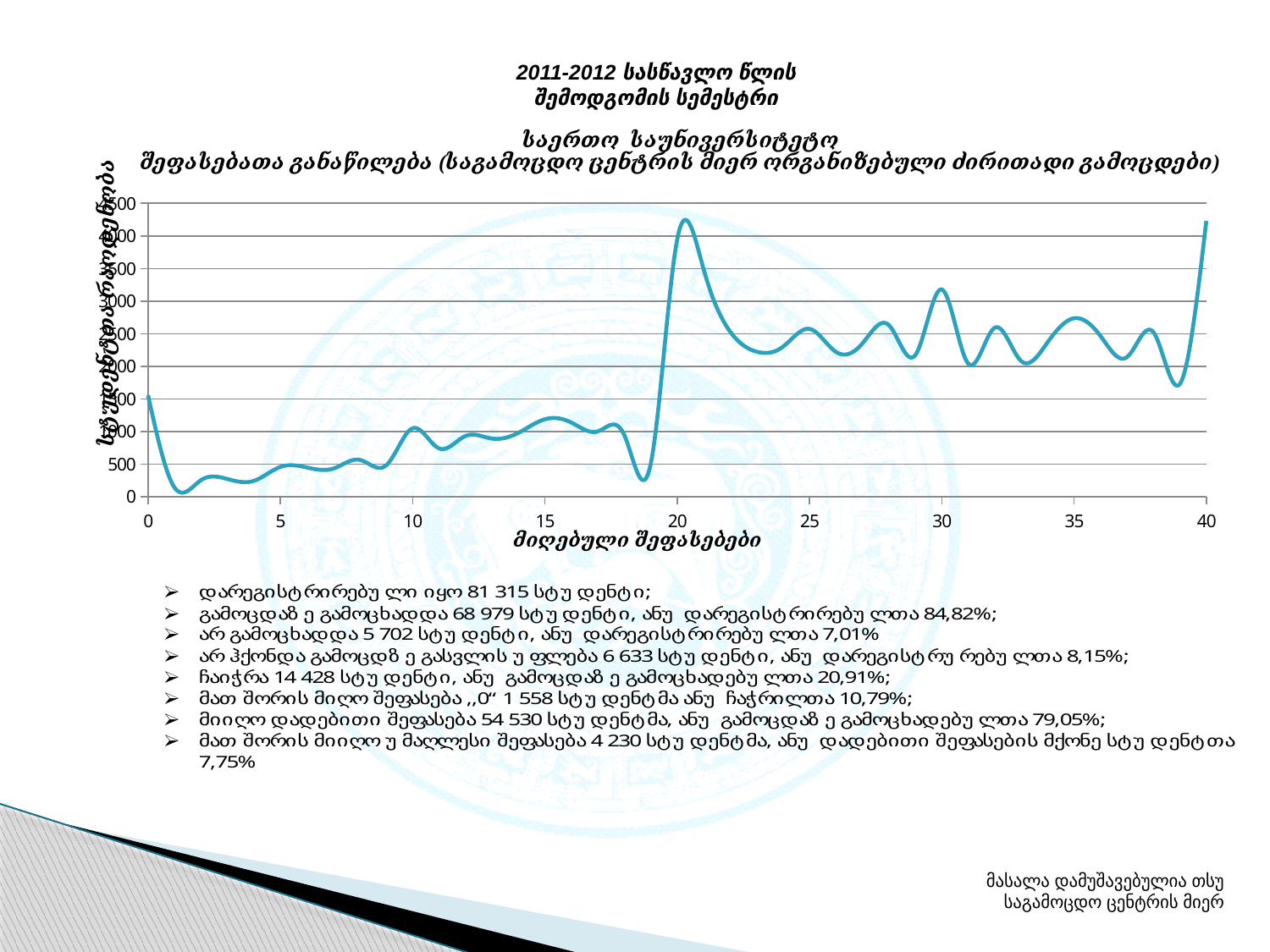
Between x = 19 and x = 20, does the line rise or fall? rise What kind of chart is shown on the slide? line chart Is the value of the line at x = 40 greater or less than 500? greater What is the highest value shown on the x axis of the chart? 40 What is the title of the x axis of the chart? მიღებული შეფასებები Which is larger, the value of the line at x = 5 or at x = 30? x = 30 Which is larger, the value of the line at x = 10 or at x = 20? x = 20 Is the value of the line at x = 20 greater or less than 500? greater Is the value of the line at x = 3 greater or less than 500? less How many lines (data series) are plotted on the chart? 1